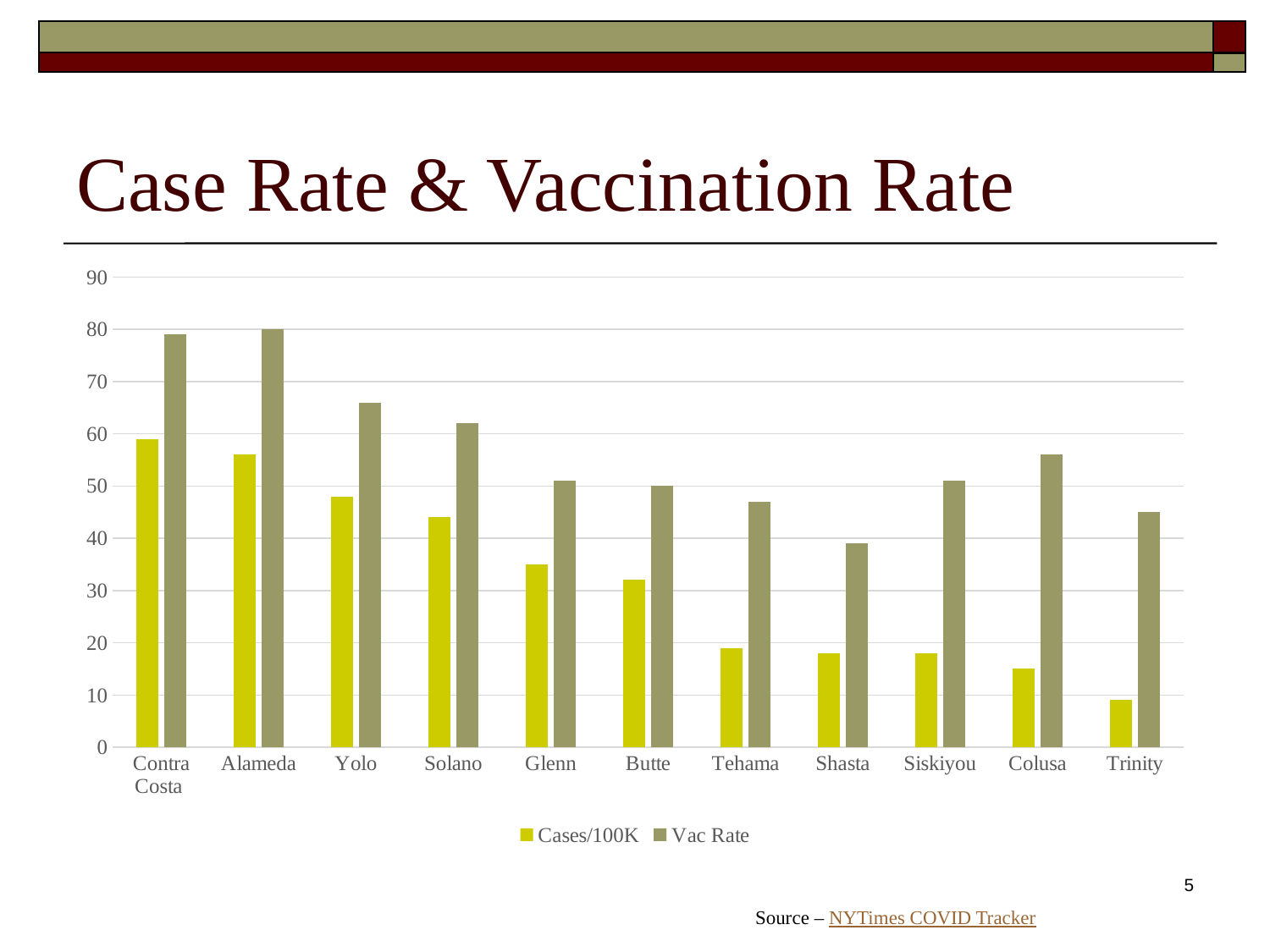
Which county has the higher Vac Rate, Colusa or Siskiyou? Colusa How many counties are shown on the x axis of the chart? 11 Do the Cases/100K values generally rise or fall moving from left to right across the counties? fall Which county has the lowest Cases/100K value? Trinity Is the Vac Rate for Contra Costa greater or less than 70? greater What is the title of the chart on the slide? Case Rate & Vaccination Rate What kind of chart is shown on the slide? bar chart Is the Cases/100K value for Trinity greater or less than 20? less How many series does the chart's legend list? 2 Which county has the lowest Vac Rate? Shasta Is the Vac Rate for Yolo greater or less than 60? greater